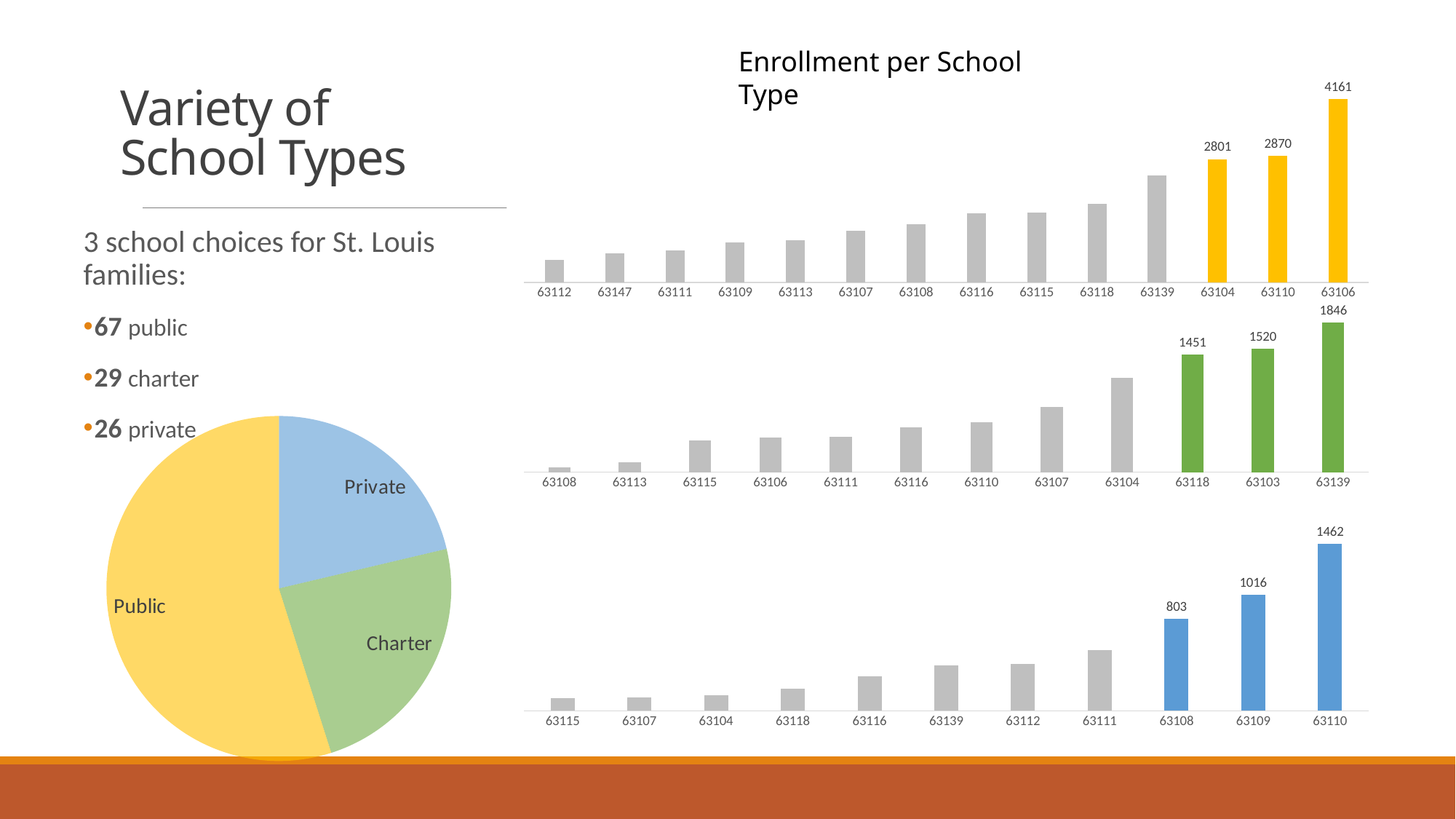
In the top bar chart under 'Enrollment per School Type', which category has the highest value? 63106 In the middle bar chart under 'Enrollment per School Type', what is the value for 63103? 1520 In the top bar chart under 'Enrollment per School Type', what is the value for 63104? 2801 In the bottom bar chart under 'Enrollment per School Type', what is the value for 63108? 803 In the pie chart on the left of the slide, which slice is the largest? Public In the middle bar chart under 'Enrollment per School Type', which is larger, the value for 63139 or the value for 63118? 63139 In the middle bar chart under 'Enrollment per School Type', which category has the lowest value? 63108 How many categories are shown in the top bar chart under 'Enrollment per School Type'? 14 In the bottom bar chart under 'Enrollment per School Type', what is the difference between the values for 63110 and 63109? 446 How many categories are shown in the bottom bar chart under 'Enrollment per School Type'? 11 In the top bar chart under 'Enrollment per School Type', what is the value for 63106? 4161 In the bottom bar chart under 'Enrollment per School Type', do the values rise or fall from left to right? rise